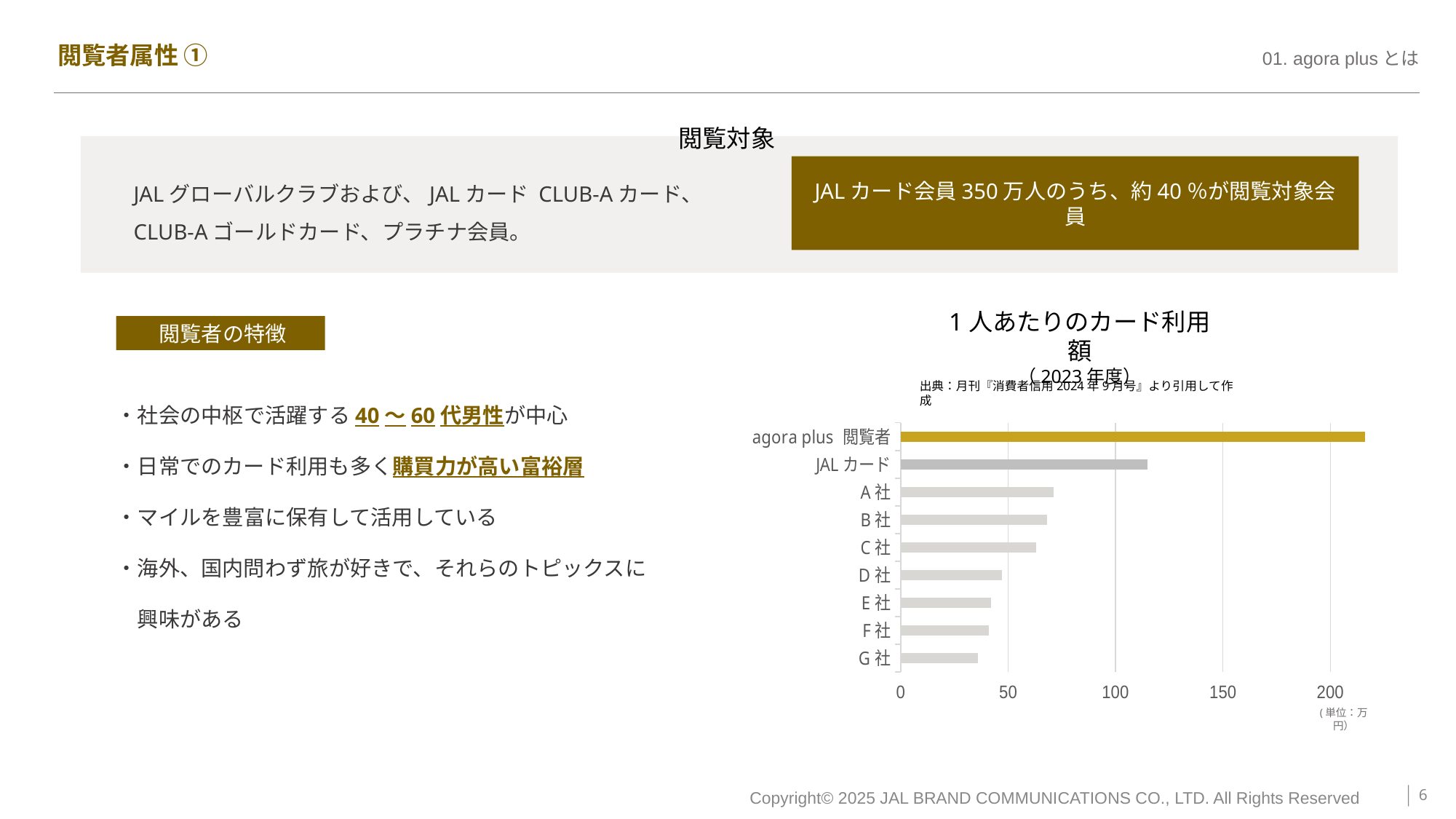
Is the value for JALカード greater or less than 100? greater Which category has the lowest value in the chart? G社 How many categories are plotted in the chart? 9 Is the value for A社 greater or less than 50? greater Which category has the highest value in the chart? agora plus 閲覧者 Which is larger, the value for JALカード or the value for A社? JALカード What unit is shown for the values in the chart? 万円 Is the value for agora plus 閲覧者 greater or less than 200? greater What kind of chart is shown on the slide? bar chart Which is larger, the value for D社 or the value for G社? D社